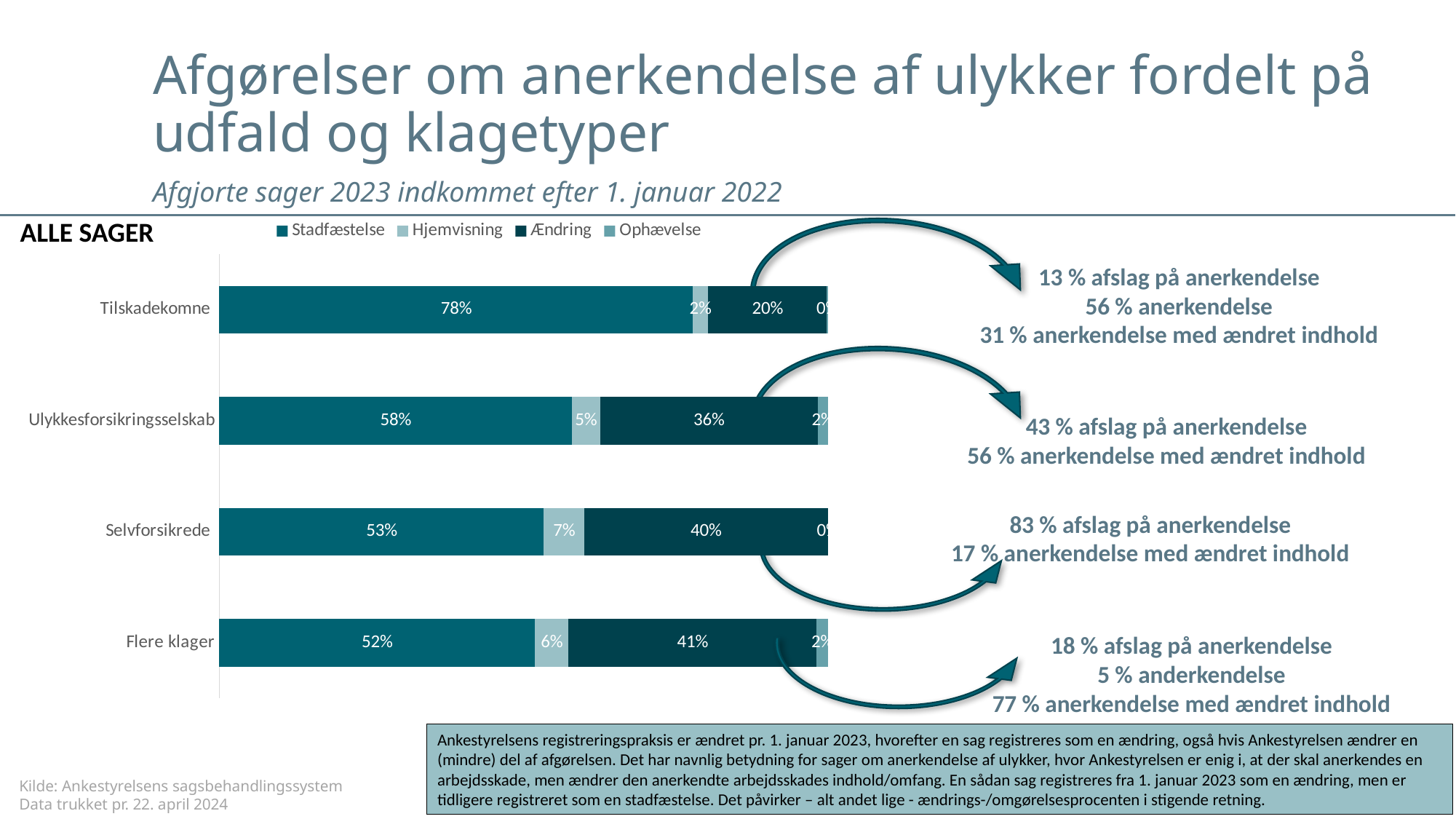
What is the Hjemvisning share for Selvforsikrede? 7% Which is larger: the Ændring share for Selvforsikrede or for Ulykkesforsikringsselskab? Selvforsikrede What kind of chart is shown on the slide? Stacked bar chart What is the Ændring share for Ulykkesforsikringsselskab? 36% Which category has the lowest Ændring share? Tilskadekomne Which category has the highest Stadfæstelse share? Tilskadekomne How many series does the legend list? 4 How many categories are shown on the chart? 4 What is the Ophævelse share for Flere klager? 2% What is the difference between the Stadfæstelse share for Tilskadekomne and for Flere klager? 26% What is the Stadfæstelse share for Tilskadekomne? 78% Which series is listed first in the chart legend? Stadfæstelse